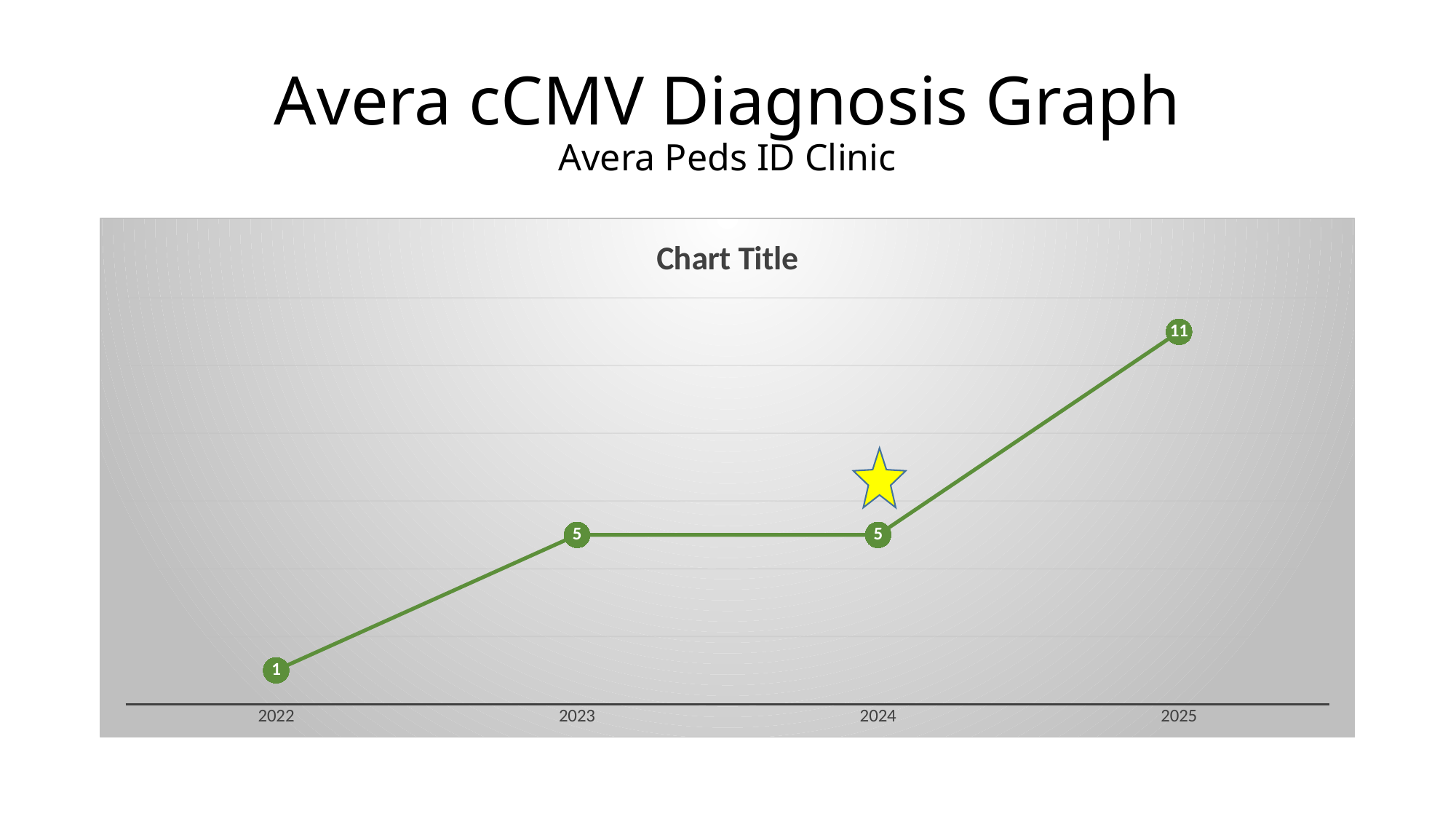
What is the value for 2022? 1 Which is larger, the value for 2025 or the value for 2023? 2025 Do the values rise or fall from 2022 to 2025? rise Which year has the highest value? 2025 Which year has the lowest value? 2022 What kind of chart is shown on the slide? line chart What is the value for 2023? 5 What is the value for 2025? 11 What is the difference between the values for 2023 and 2022? 4 How many years are plotted on the x axis? 4 What is the value for 2024? 5 What is the difference between the values for 2025 and 2024? 6